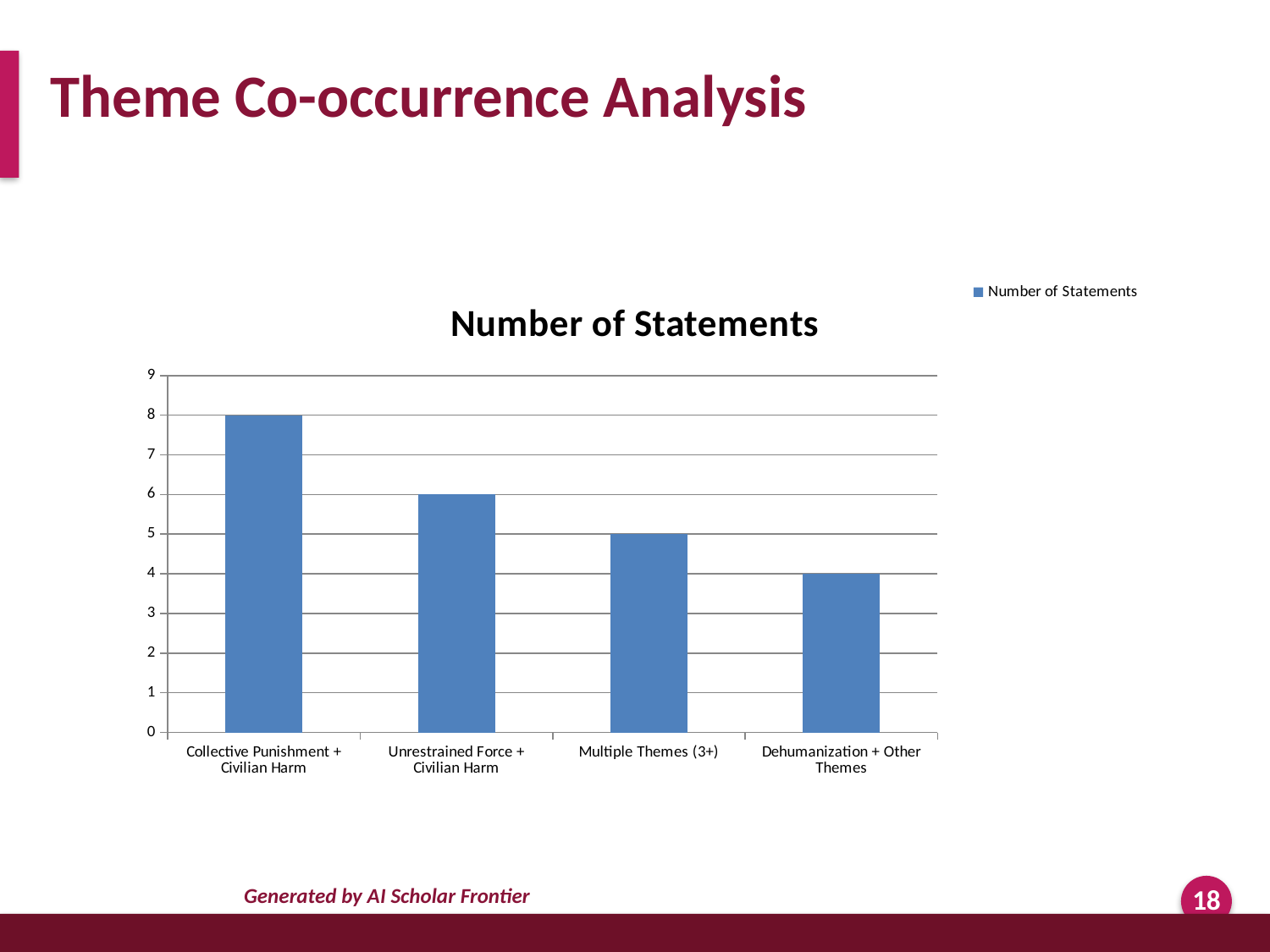
What kind of chart is shown? bar chart What is the value for Unrestrained Force + Civilian Harm? 6 Which is larger, Unrestrained Force + Civilian Harm or Multiple Themes (3+)? Unrestrained Force + Civilian Harm What is the difference between Collective Punishment + Civilian Harm and Dehumanization + Other Themes? 4 What is the value for Collective Punishment + Civilian Harm? 8 Which category has the lowest number of statements? Dehumanization + Other Themes Which category has the highest number of statements? Collective Punishment + Civilian Harm Do the values rise or fall from left to right along the x axis? fall What is the value for Multiple Themes (3+)? 5 What is the value for Dehumanization + Other Themes? 4 How many categories are shown on the x axis? 4 How many series does the legend list? 1